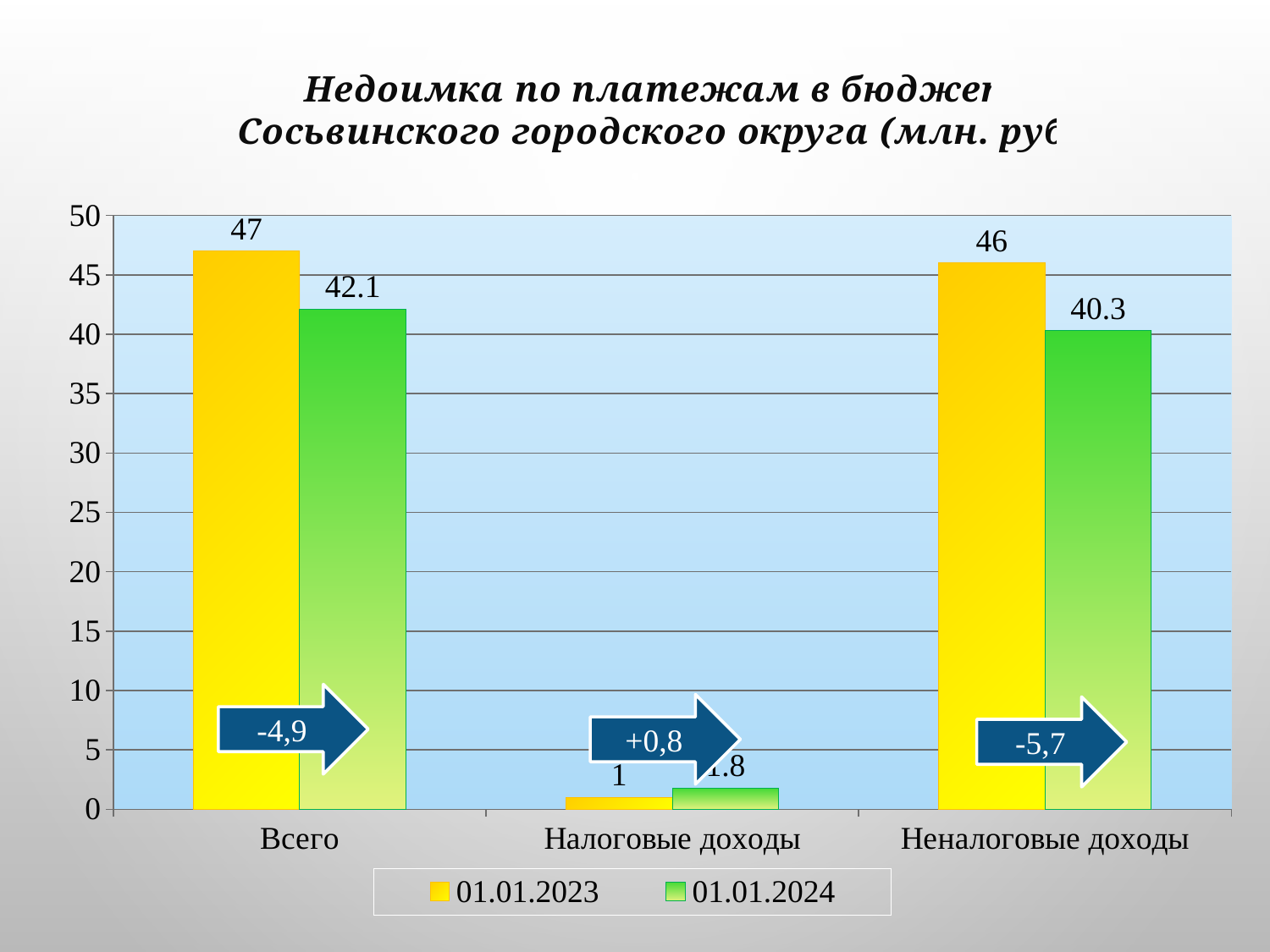
What kind of chart is shown on the slide? bar chart What is the value for Неналоговые доходы in the 01.01.2024 series? 40.3 What is the difference between the 01.01.2023 and 01.01.2024 values for Неналоговые доходы? 5.7 Which category has the lowest value in the 01.01.2024 series? Налоговые доходы How many categories are shown on the x axis? 3 How many series does the legend list? 2 What is the value for Налоговые доходы in the 01.01.2023 series? 1 What is the value for Всего in the 01.01.2023 series? 47 What is the value for Всего in the 01.01.2024 series? 42.1 Is the 01.01.2024 value for Неналоговые доходы greater or less than 45? less Which is larger for Налоговые доходы: the 01.01.2023 value or the 01.01.2024 value? 01.01.2024 Which category has the highest value in the 01.01.2023 series? Всего